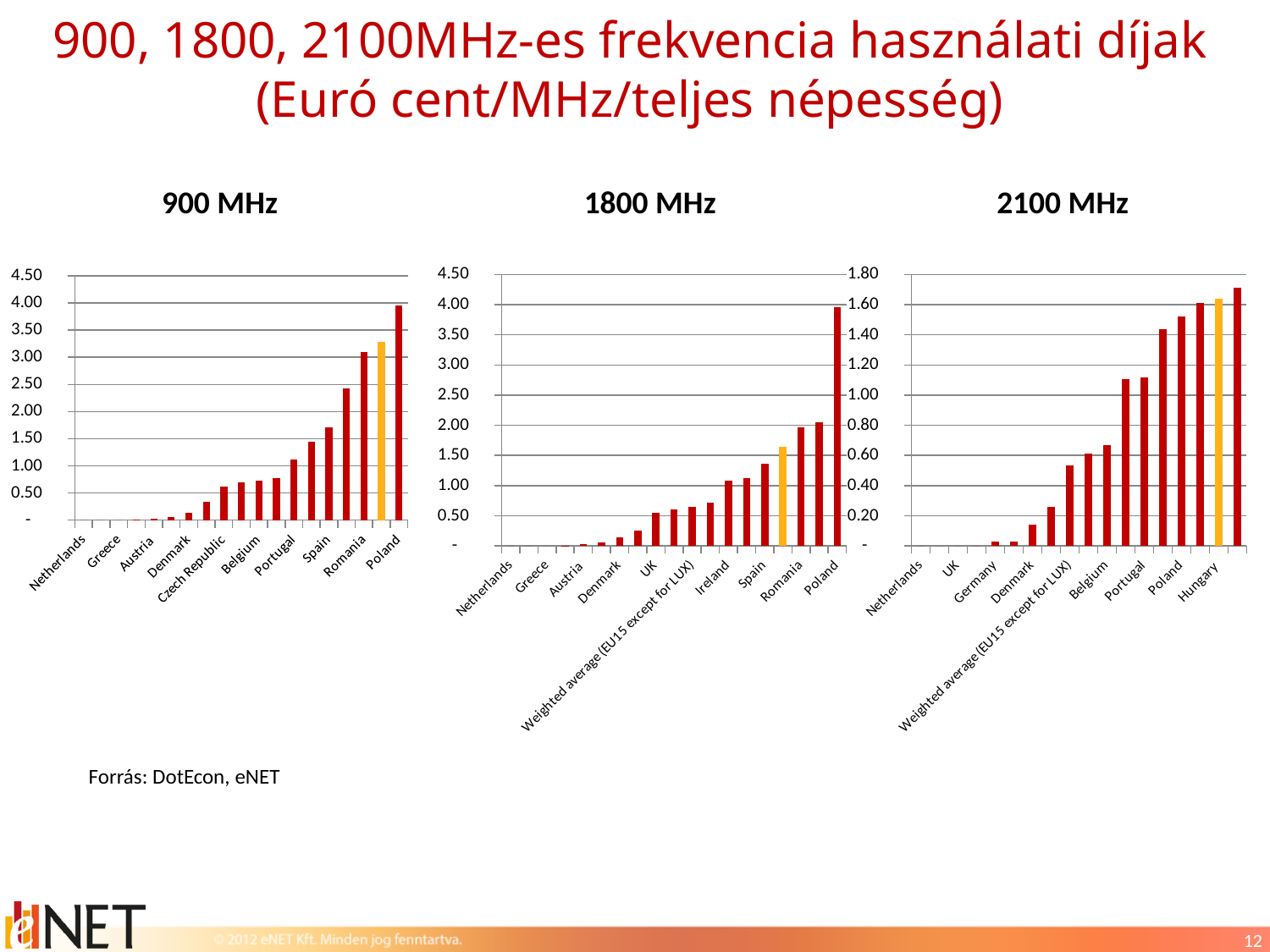
In the 2100 MHz chart, is the value for Hungary greater or less than 1.40? greater In the 900 MHz chart, is the value for Netherlands greater or less than 0.50? less In the 1800 MHz chart, which labelled country has the highest value? Poland In the 2100 MHz chart, do the values rise or fall from left to right along the x axis? rise In the 900 MHz chart, which labelled country has the lowest value? Netherlands and Greece (both 0) In the 1800 MHz chart, is the value for Poland greater or less than 3.50? greater In the 1800 MHz chart, which is larger, the value for Poland or the value for Netherlands? Poland What kind of chart is the 900 MHz chart? bar chart In the 2100 MHz chart, which labelled country has the highest value? Hungary How many charts are shown on the slide? 3 In the 900 MHz chart, which labelled country has the highest value? Poland